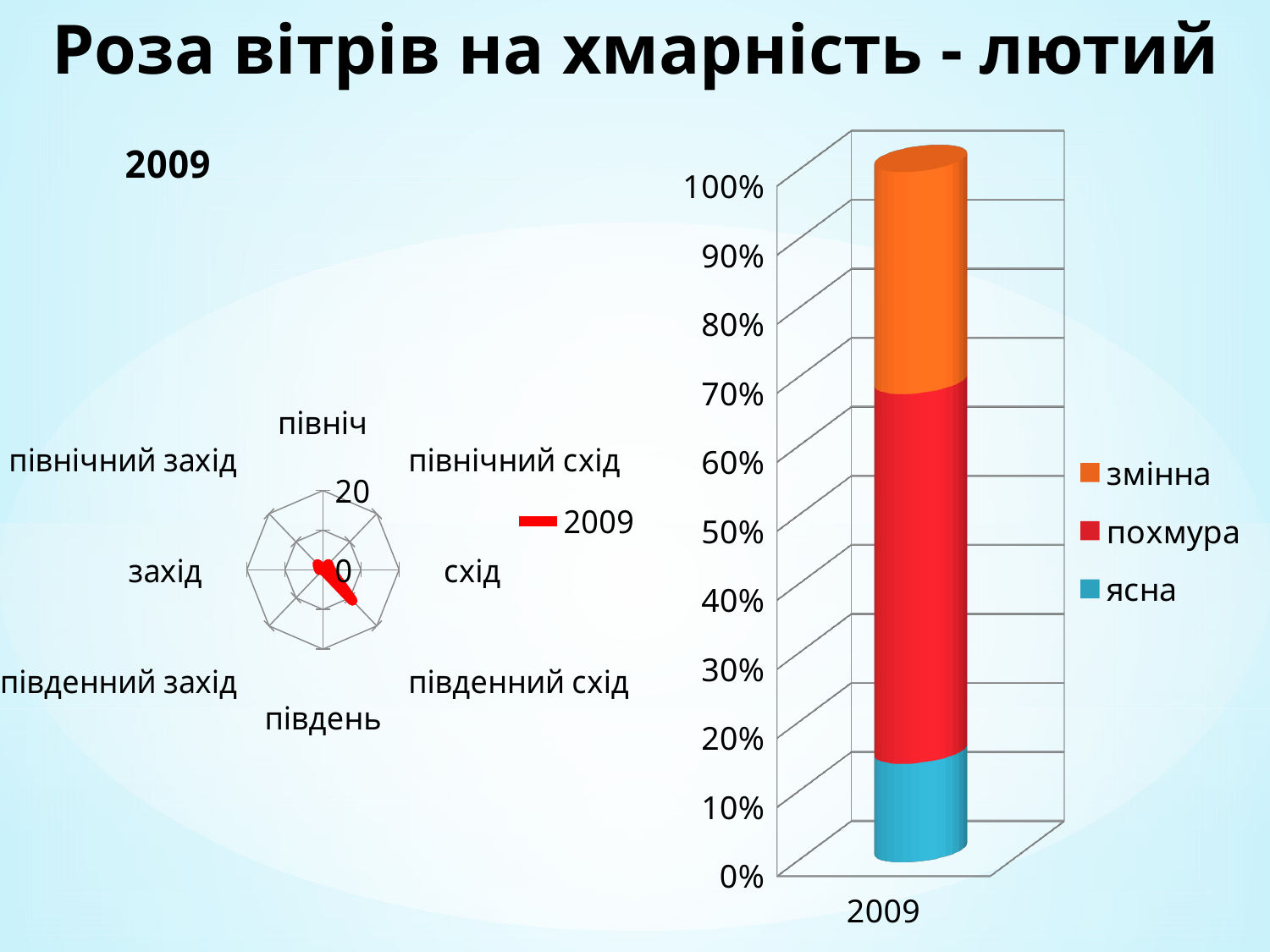
What kind of chart is the chart on the right side of the slide? bar chart In the right-hand stacked bar chart, which series takes up the smallest share of the 2009 bar? ясна How many categories are shown on the x axis of the right-hand stacked bar chart? 1 In the right-hand stacked bar chart, is the share of ясна for 2009 greater or less than 30%? less What is the maximum value shown on the radial axis of the left-hand radar chart? 20 What kind of chart is the chart on the left side of the slide? radar chart How many series does the legend of the left-hand radar chart list? 1 How many direction categories are shown on the left-hand radar chart? 8 In the right-hand stacked bar chart, which series takes up the largest share of the 2009 bar? похмура In the right-hand stacked bar chart, is the share of похмура for 2009 larger or smaller than the share of змінна? larger In the right-hand stacked bar chart, is the share of ясна for 2009 greater or less than 10%? greater How many series does the legend of the right-hand stacked bar chart list? 3